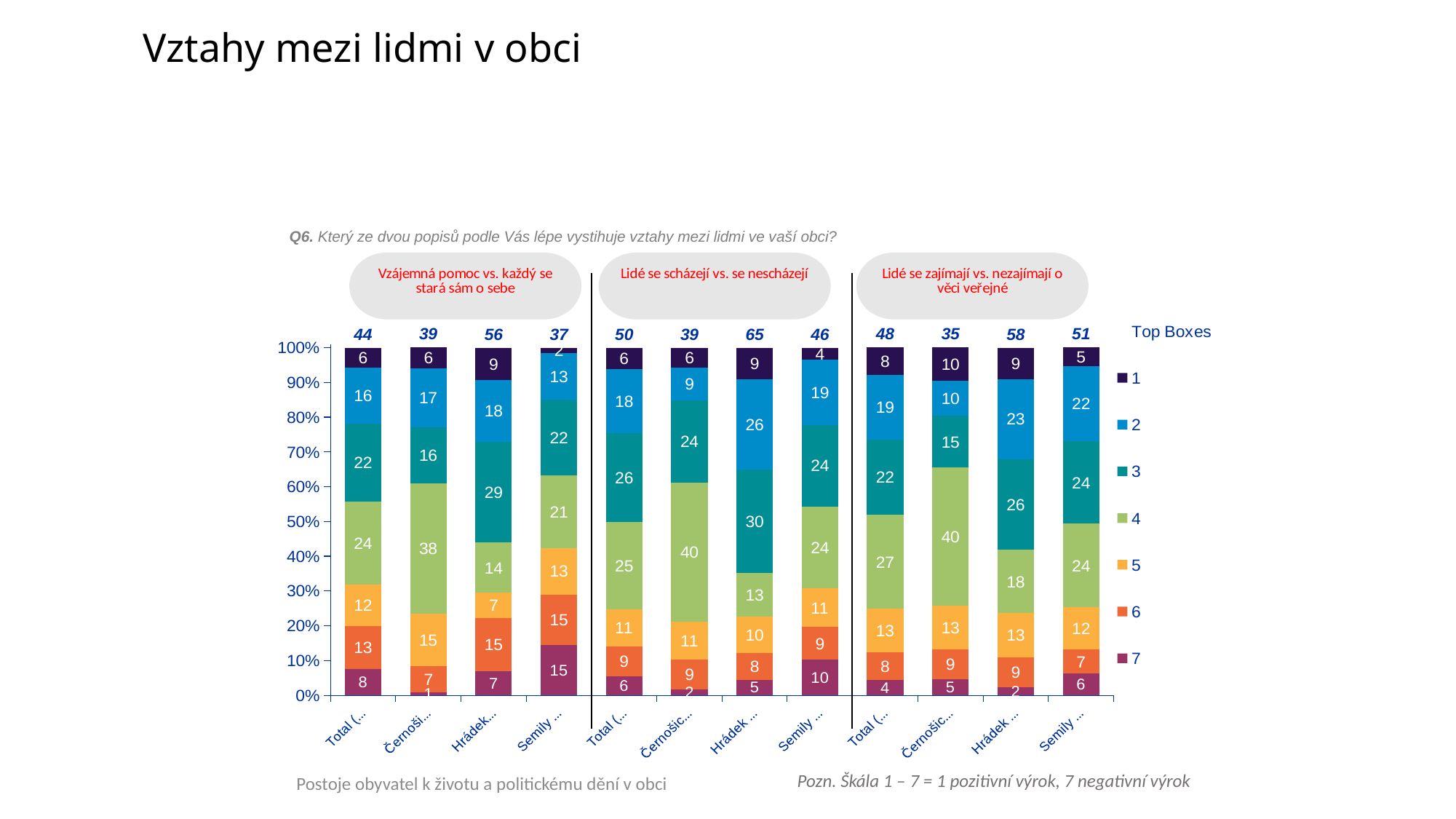
In the 'Vzájemná pomoc vs. každý se stará sám o sebe' section, what is the difference between the Top Boxes values of Hrádek and Semily? 19 How many bars are plotted in the chart in total? 12 In the 'Lidé se zajímají vs. nezajímají o věci veřejné' section, which has the larger value for series 2: Total or Semily? Semily Which bar has the lowest Top Boxes value across the whole chart? Černošice in 'Lidé se zajímají vs. nezajímají o věci veřejné' (35) What kind of chart is shown on the slide? stacked bar chart What is the Top Boxes value for Hrádek in the 'Lidé se scházejí vs. se nescházejí' section? 65 How many series does the legend list? 7 In the 'Vzájemná pomoc vs. každý se stará sám o sebe' section, what is the value of series 4 for Černošice? 38 In the 'Vzájemná pomoc vs. každý se stará sám o sebe' section, what is the value of series 3 for Hrádek? 29 Which bar has the highest Top Boxes value across the whole chart? Hrádek in 'Lidé se scházejí vs. se nescházejí' (65) How many question sections (grey header boxes) does the chart have? 3 In the 'Vzájemná pomoc vs. každý se stará sám o sebe' section, what is the value of series 7 for Semily? 15